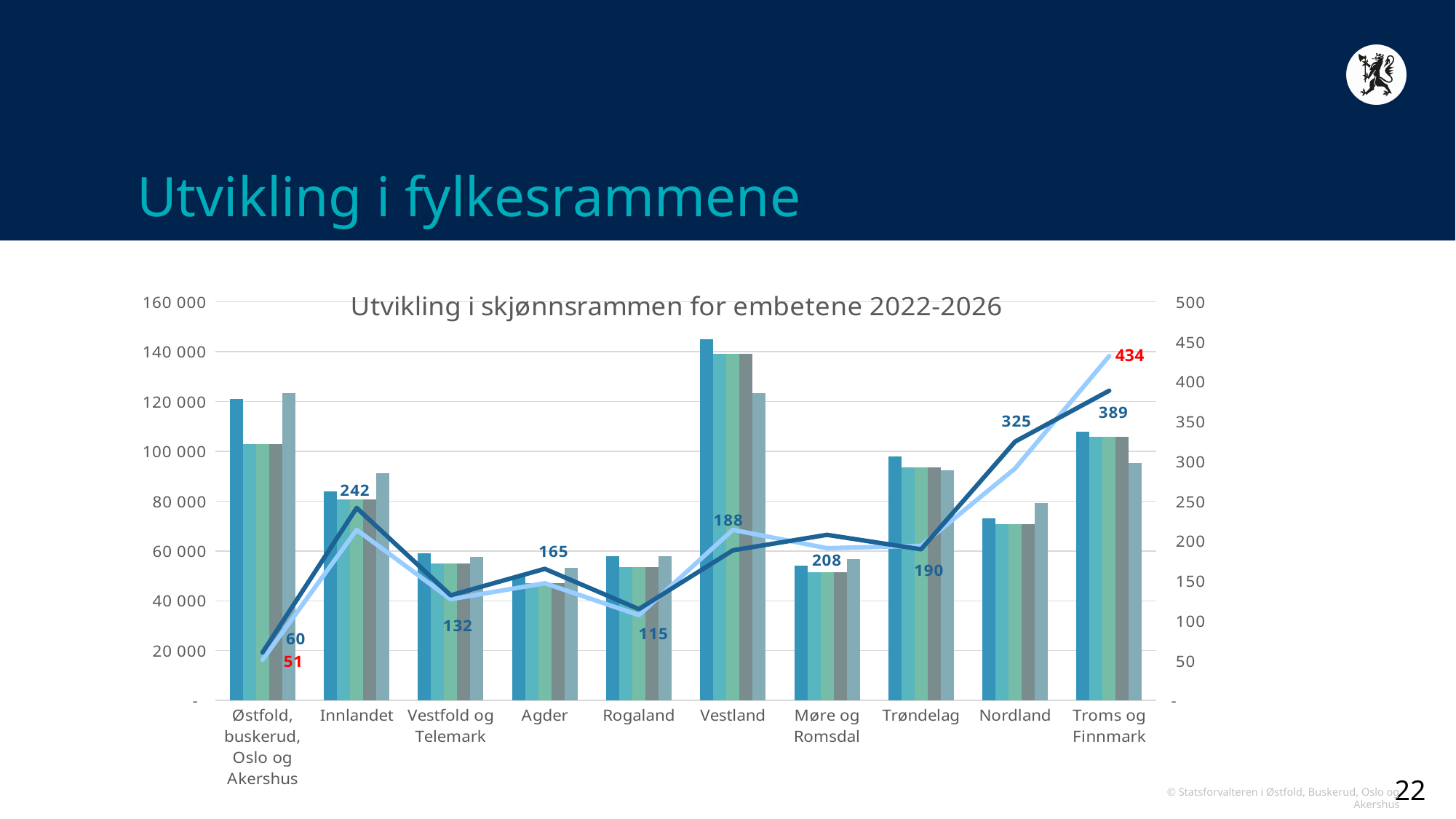
What is the labelled value of the dark blue line for Innlandet? 242 Which region has the lowest labelled value on the dark blue line? Østfold, buskerud, Oslo og Akershus What is the difference between the two labelled line values for Troms og Finnmark (434 and 389)? 45 What is the red labelled value of the light blue line for Troms og Finnmark? 434 What is the labelled value of the dark blue line for Nordland? 325 What kind of chart is shown on the slide? A combined bar and line chart Does the dark blue line rise or fall from Trøndelag to Troms og Finnmark? Rise Is the tallest bar for Vestland greater or less than 140 000 on the left axis? greater How many categories (regions) are shown on the x axis of the chart? 10 What is the title of the chart? Utvikling i skjønnsrammen for embetene 2022-2026 Which region has the highest labelled value on the dark blue line? Troms og Finnmark